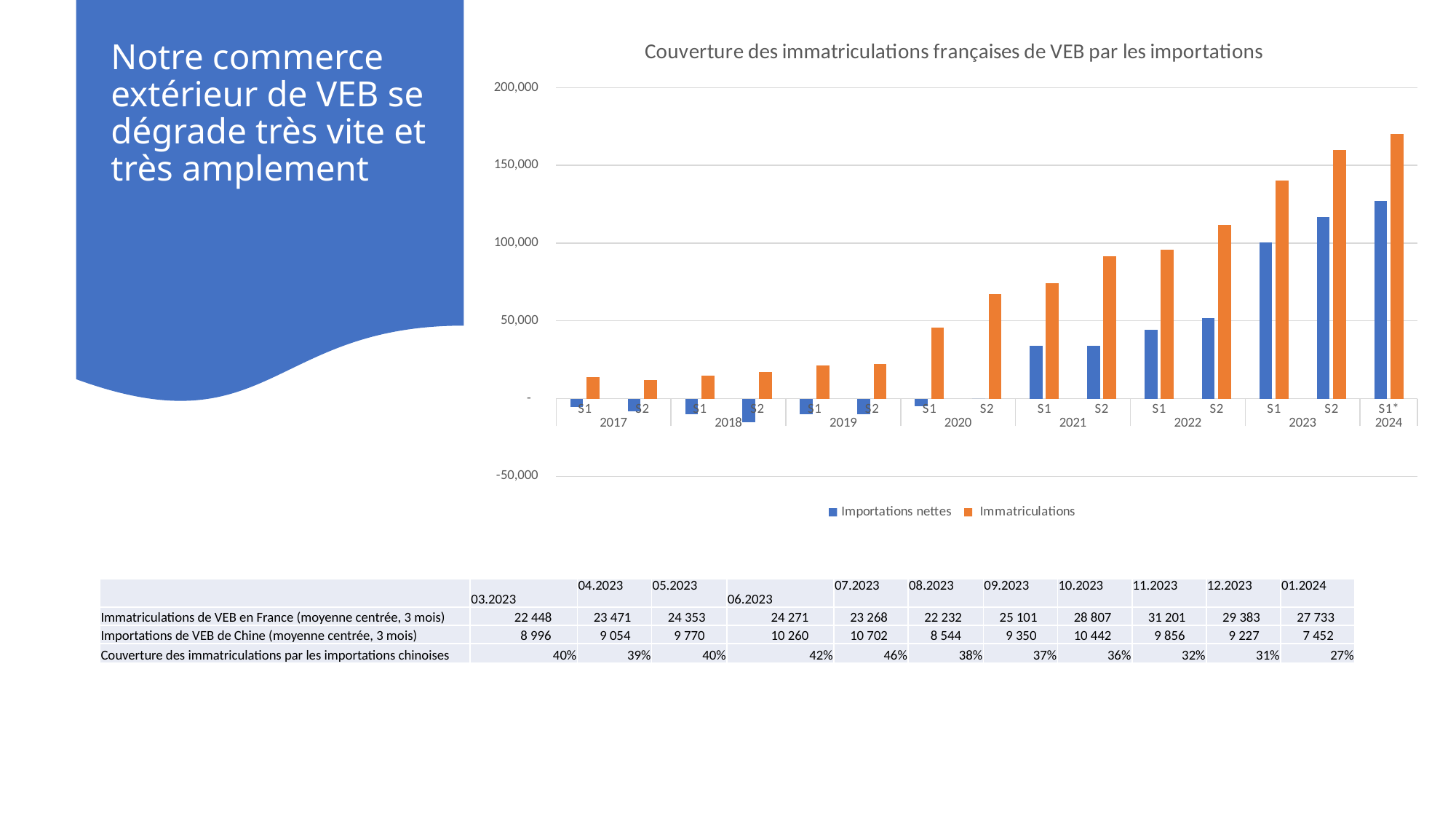
Is the Importations nettes value for S1 2021 greater or less than 50,000? less What kind of chart is shown on the slide? bar chart How many half-year periods (categories) are plotted on the x axis of the chart? 15 In which period is the Immatriculations value highest? S1* 2024 What is the title of the chart? Couverture des immatriculations françaises de VEB par les importations Do the Immatriculations values generally rise or fall from 2017 to 2024? rise How many series does the chart legend list? 2 Is the Immatriculations value for S1 2021 greater or less than 50,000? greater Is the Immatriculations value for S1* 2024 greater or less than 150,000? greater What are the two series named in the chart legend? Importations nettes and Immatriculations For S1 2023, which series has the larger value: Importations nettes or Immatriculations? Immatriculations